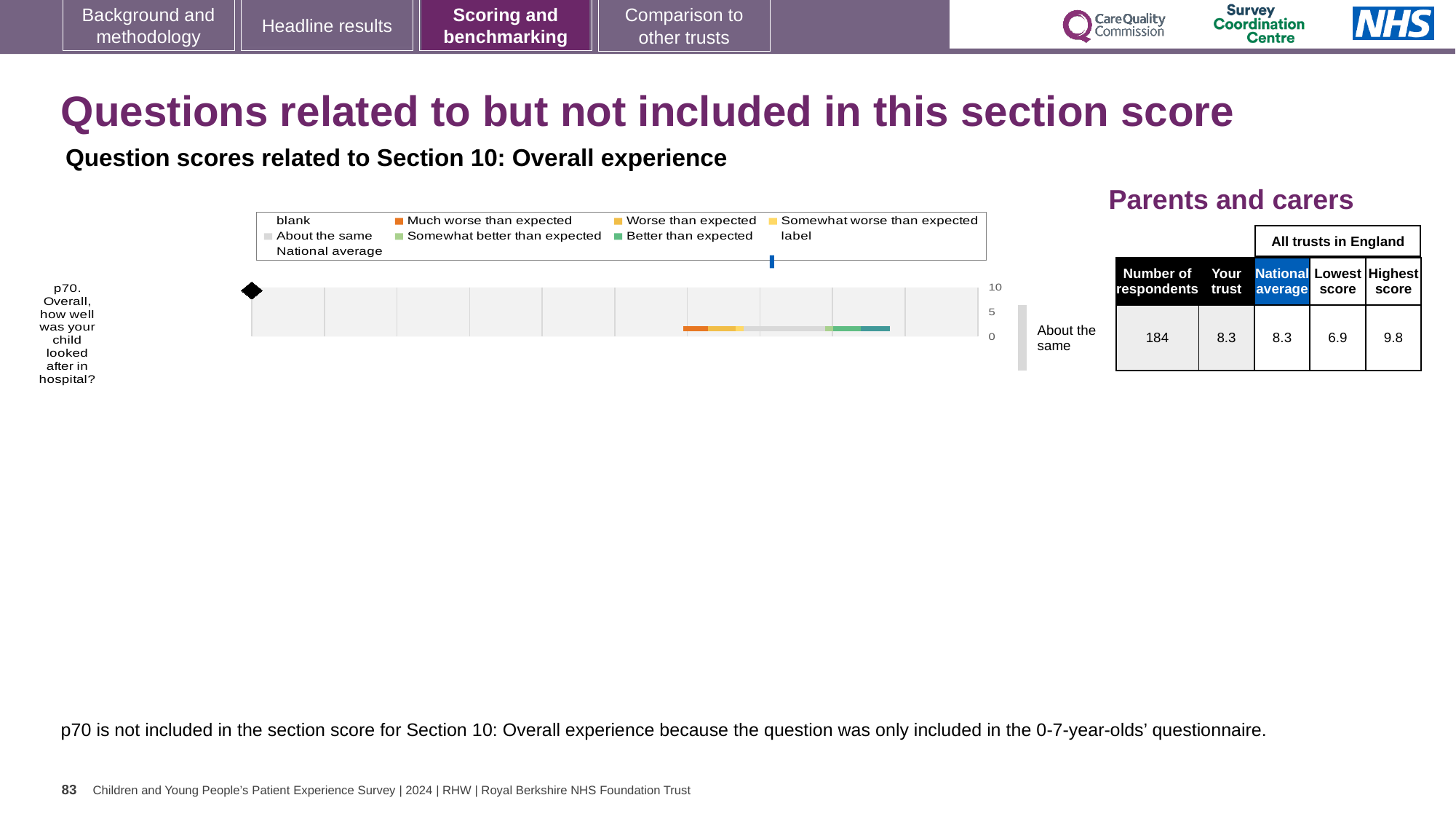
Which question is plotted in the chart? p70. Overall, how well was your child looked after in hospital? How many survey questions are plotted in the chart? 1 Which benchmarking category is the trust's p70 result labelled as? About the same Is the trust's score for p70 greater or less than 5? greater What is the national average score for p70? 8.3 What is the lowest score among all trusts in England for p70? 6.9 How many respondents answered p70? 184 What kind of chart is shown for question p70? bar chart Is the trust's score for p70 higher than, lower than, or the same as the national average? the same What is the 'Your trust' score for p70 shown in the table beside the chart? 8.3 What is the highest score among all trusts in England for p70? 9.8 What is the difference between the highest and lowest trust scores for p70? 2.9